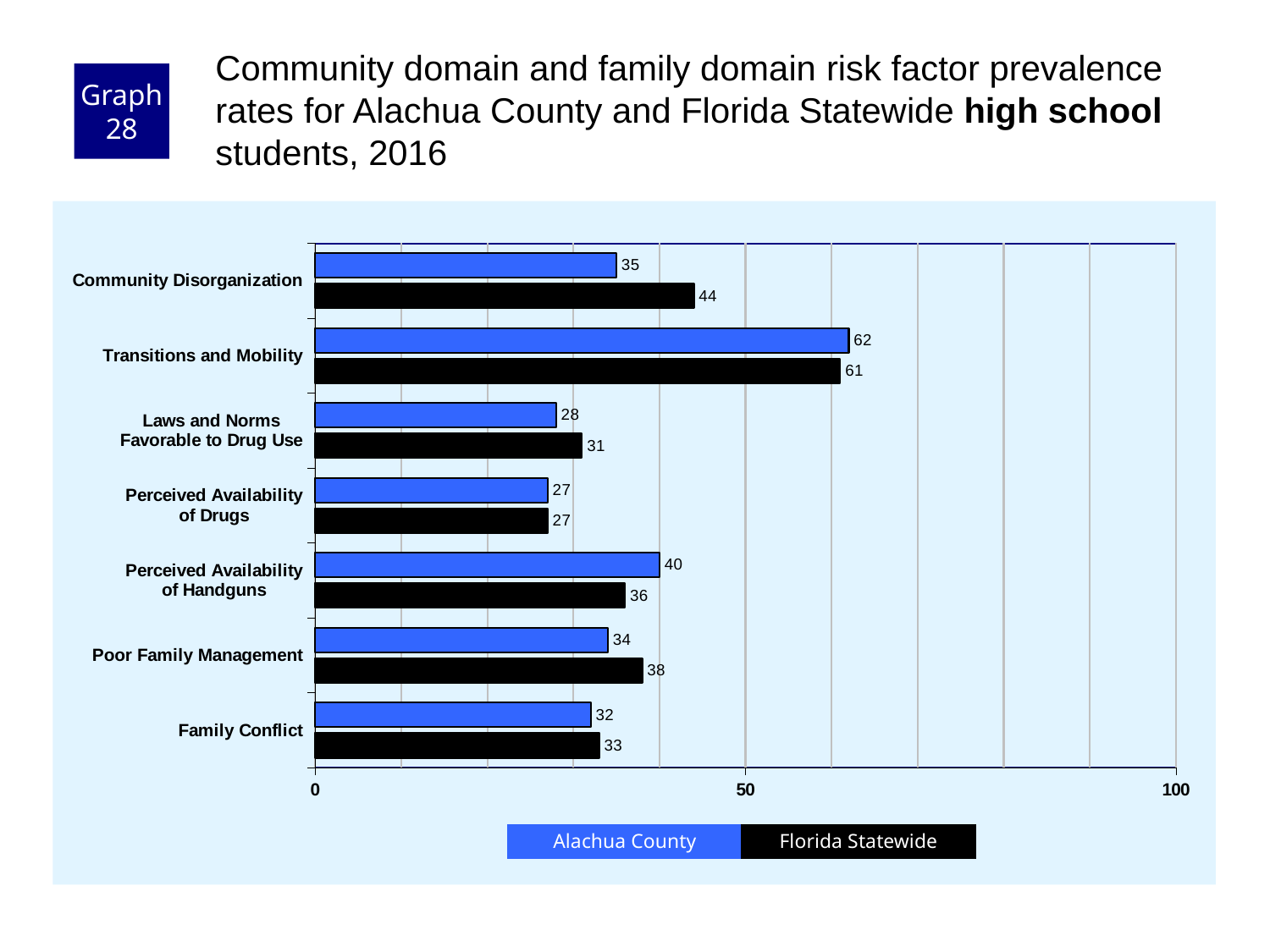
What is the Florida Statewide value for Community Disorganization? 44 How many risk factor categories are shown on the chart? 7 What is the Florida Statewide value for Poor Family Management? 38 Which colour represents Florida Statewide in the chart? Black Is the Alachua County value for Transitions and Mobility greater or less than 50? greater Which risk factor has the lowest Florida Statewide value? Perceived Availability of Drugs What is the Alachua County value for Transitions and Mobility? 62 For Perceived Availability of Handguns, which is larger: the Alachua County value or the Florida Statewide value? Alachua County Which risk factor has the highest Alachua County value? Transitions and Mobility How many series does the legend list? 2 What kind of chart is shown on the slide? Bar chart What is the difference between the Florida Statewide and Alachua County values for Community Disorganization? 9